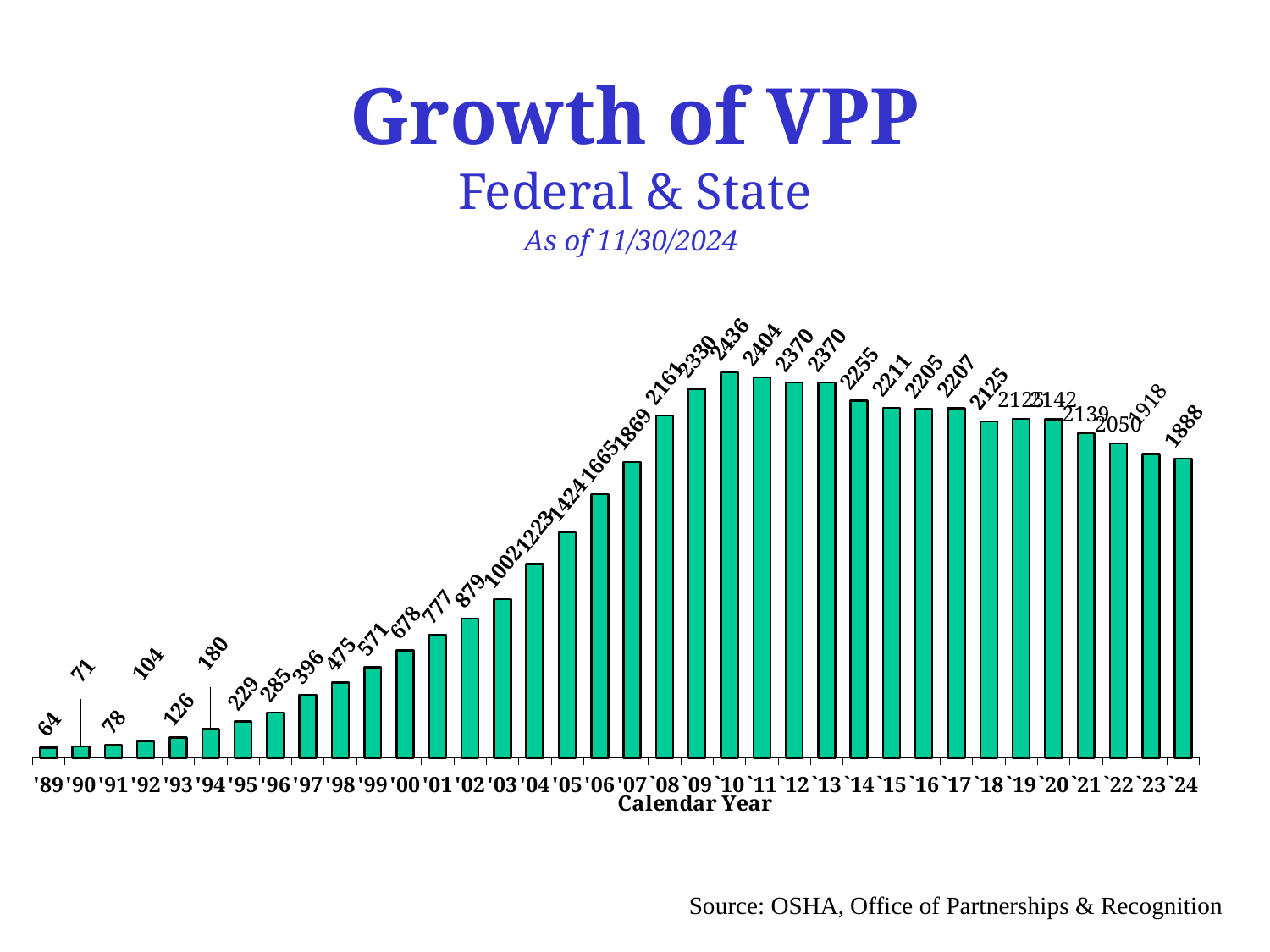
What is the label of the x axis? Calendar Year What type of chart is shown on the slide? bar chart What is the title of the chart? Growth of VPP What is the value for calendar year '89? 64 Which calendar year has the highest value? '10 What is the value for calendar year '10? 2436 Do the values rise or fall from '89 to '10? rise Which has a larger value, '08 or '14? '14 What is the difference between the values for '10 and '24? 548 Which calendar year has the lowest value? '89 What is the value for calendar year '03? 1002 What is the value for calendar year '24? 1888